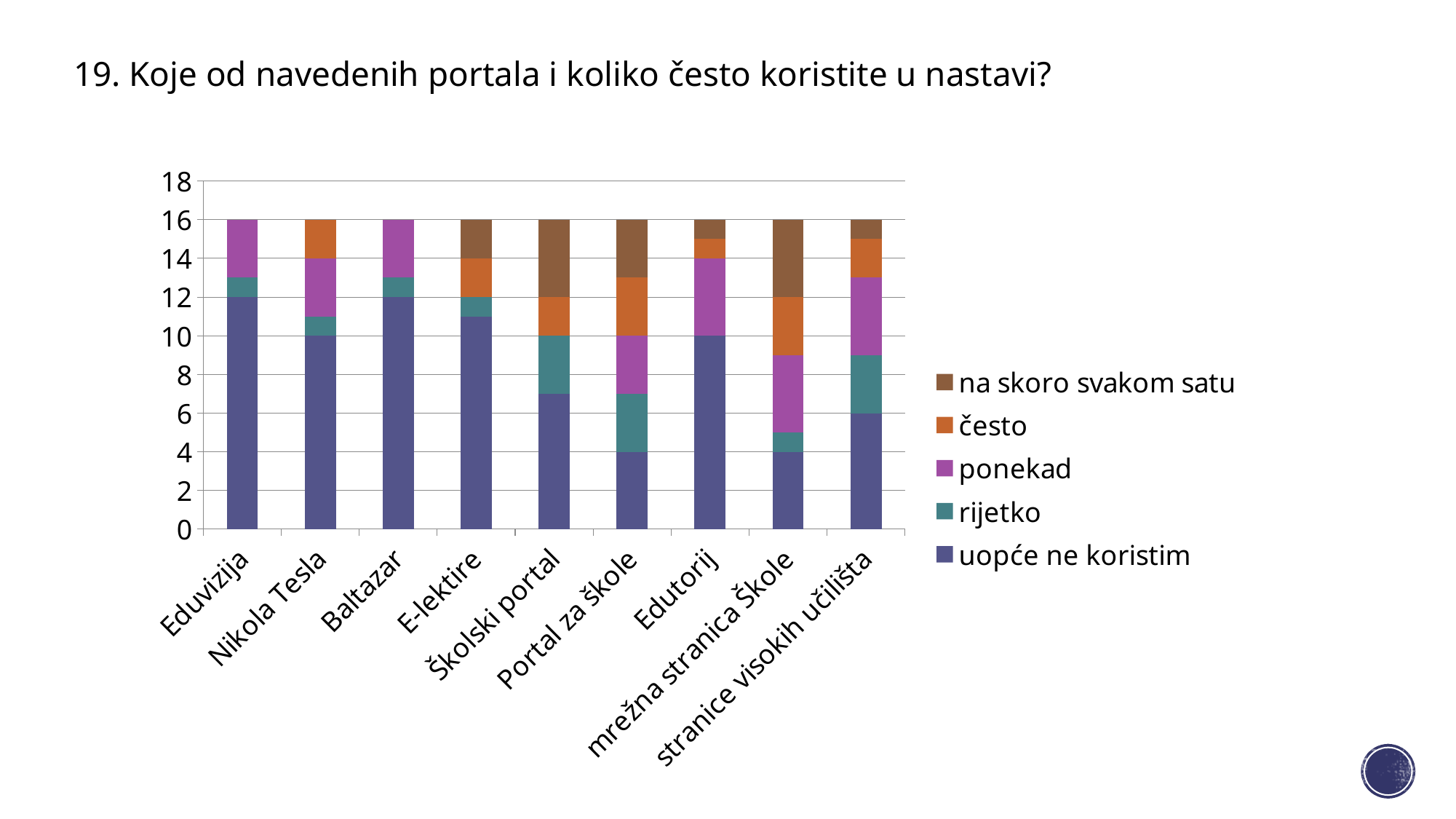
Which is larger for 'uopće ne koristim': Eduvizija or Nikola Tesla? Eduvizija What is the value of 'uopće ne koristim' for stranice visokih učilišta? 6 What is the difference between the 'uopće ne koristim' values for Eduvizija and stranice visokih učilišta? 6 What is the value of 'uopće ne koristim' for Eduvizija? 12 Which legend entry is listed first (at the top of the legend)? na skoro svakom satu Is the 'uopće ne koristim' value for E-lektire greater or less than 10? greater What is the total height of the stacked bar for Nikola Tesla? 16 What kind of chart is shown on the slide? stacked bar chart How many portals (categories) are shown on the x axis? 9 Is the 'uopće ne koristim' value for Školski portal greater or less than 6? greater How many series does the legend list? 5 What is the title of the slide above the chart? 19. Koje od navedenih portala i koliko često koristite u nastavi?